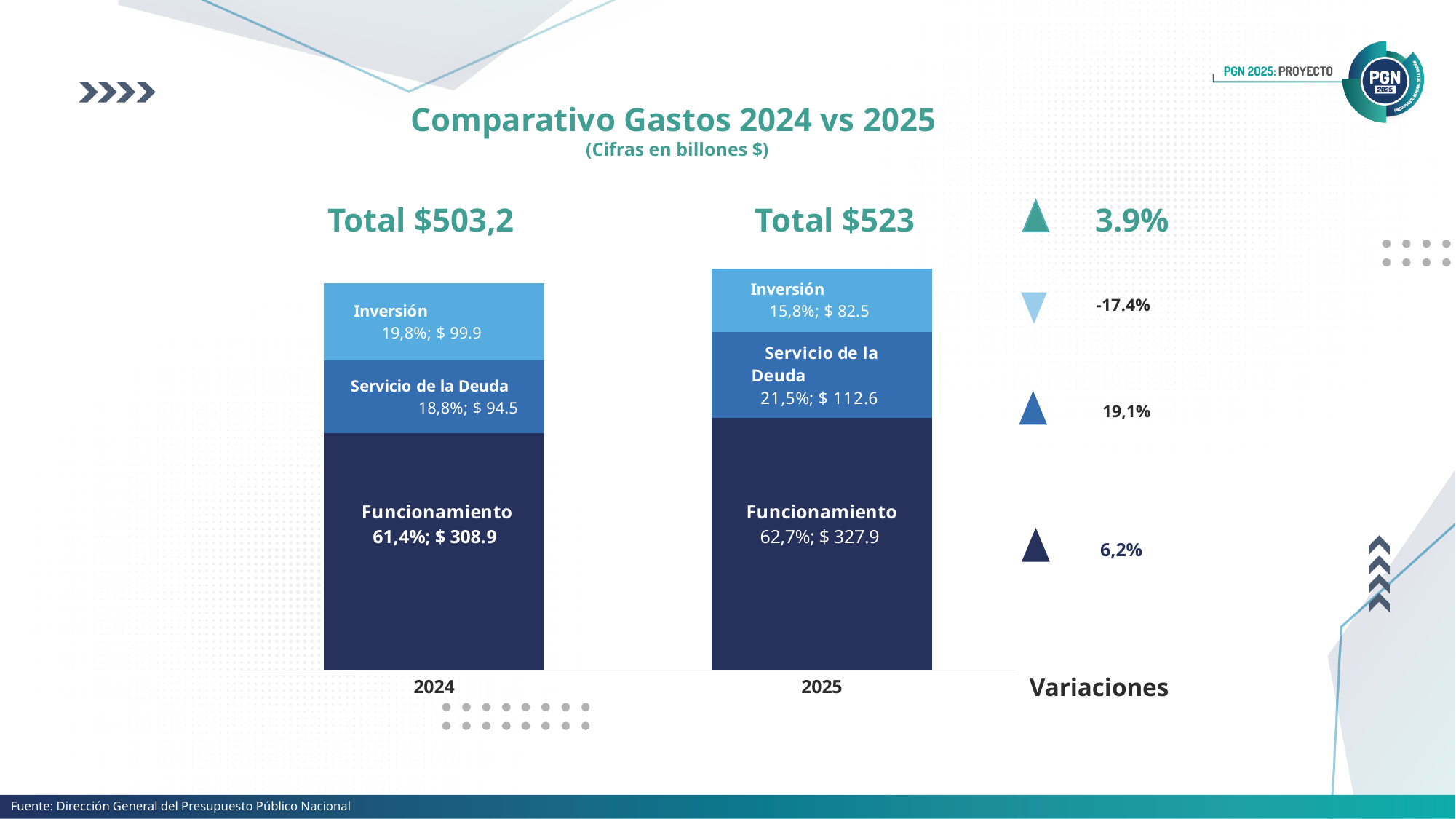
Which segment is the largest in the 2025 bar? Funcionamiento What is the total shown for 2025? $523 What kind of chart is shown on the slide? stacked bar chart What is the difference between Funcionamiento in 2025 and Funcionamiento in 2024? $ 19.0 What variation percentage is shown for Inversión between 2024 and 2025? -17.4% What is the total shown for 2024? $503,2 What is the value of Funcionamiento for 2024? $ 308.9 Is Servicio de la Deuda larger in 2024 or in 2025? 2025 What is the value of Inversión for 2025? $ 82.5 Which segment is the smallest in the 2025 bar? Inversión What is the title of the chart? Comparativo Gastos 2024 vs 2025 What percentage share does Servicio de la Deuda have in 2025? 21,5%